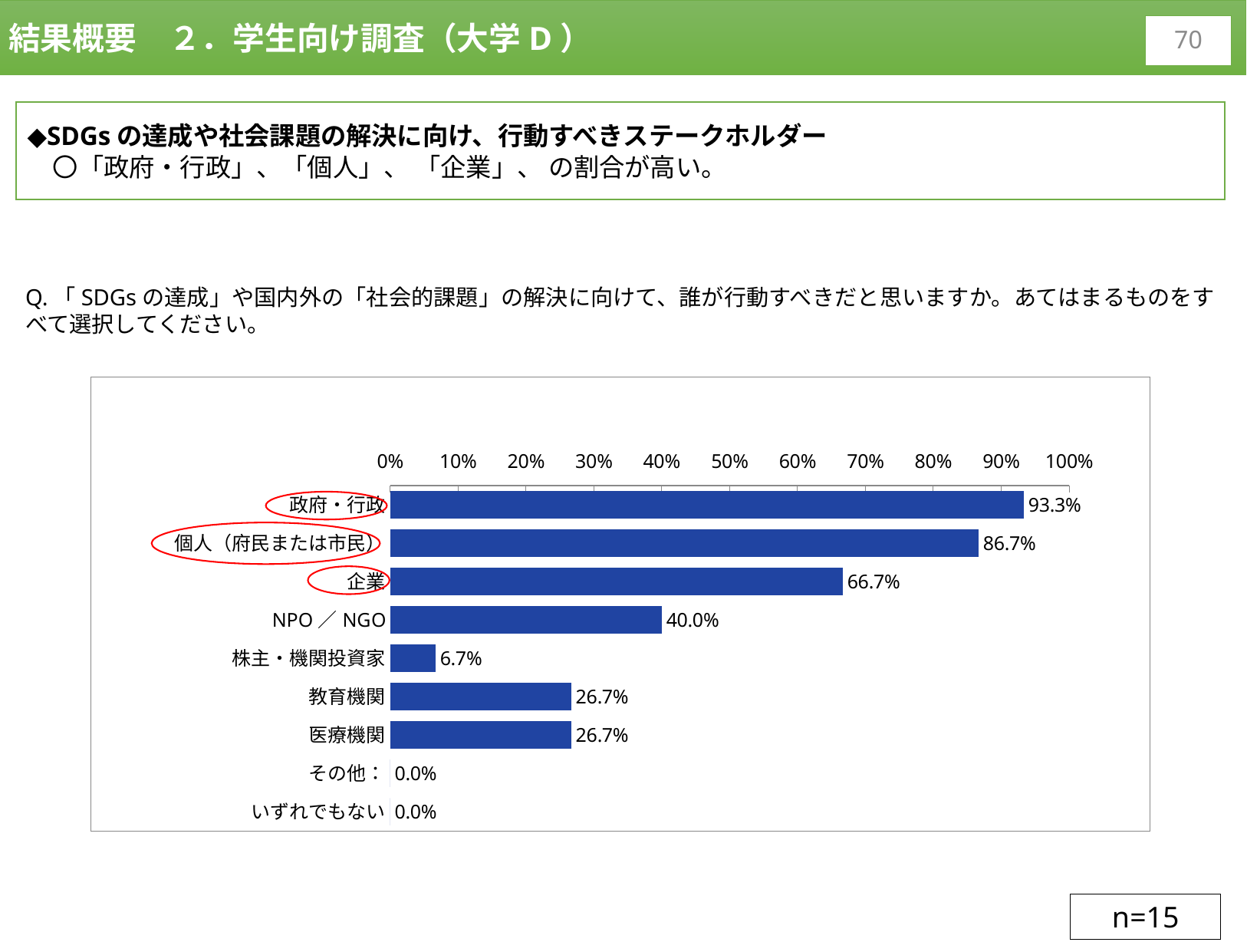
What is the value for 個人（府民または市民）? 86.7% What is the difference between the values for 個人（府民または市民） and NPO／NGO? 46.7% What kind of chart is shown on the slide? bar chart How many categories have a value of 0.0%? 2 Which category has the highest value? 政府・行政 How many categories are shown on the chart? 9 Which is larger, the value for 企業 or the value for 教育機関? 企業 What is the value for 株主・機関投資家? 6.7% What is the value for 医療機関? 26.7% What is the value for 政府・行政? 93.3% What is the value for NPO／NGO? 40.0% What is the difference between the values for 政府・行政 and 企業? 26.6%